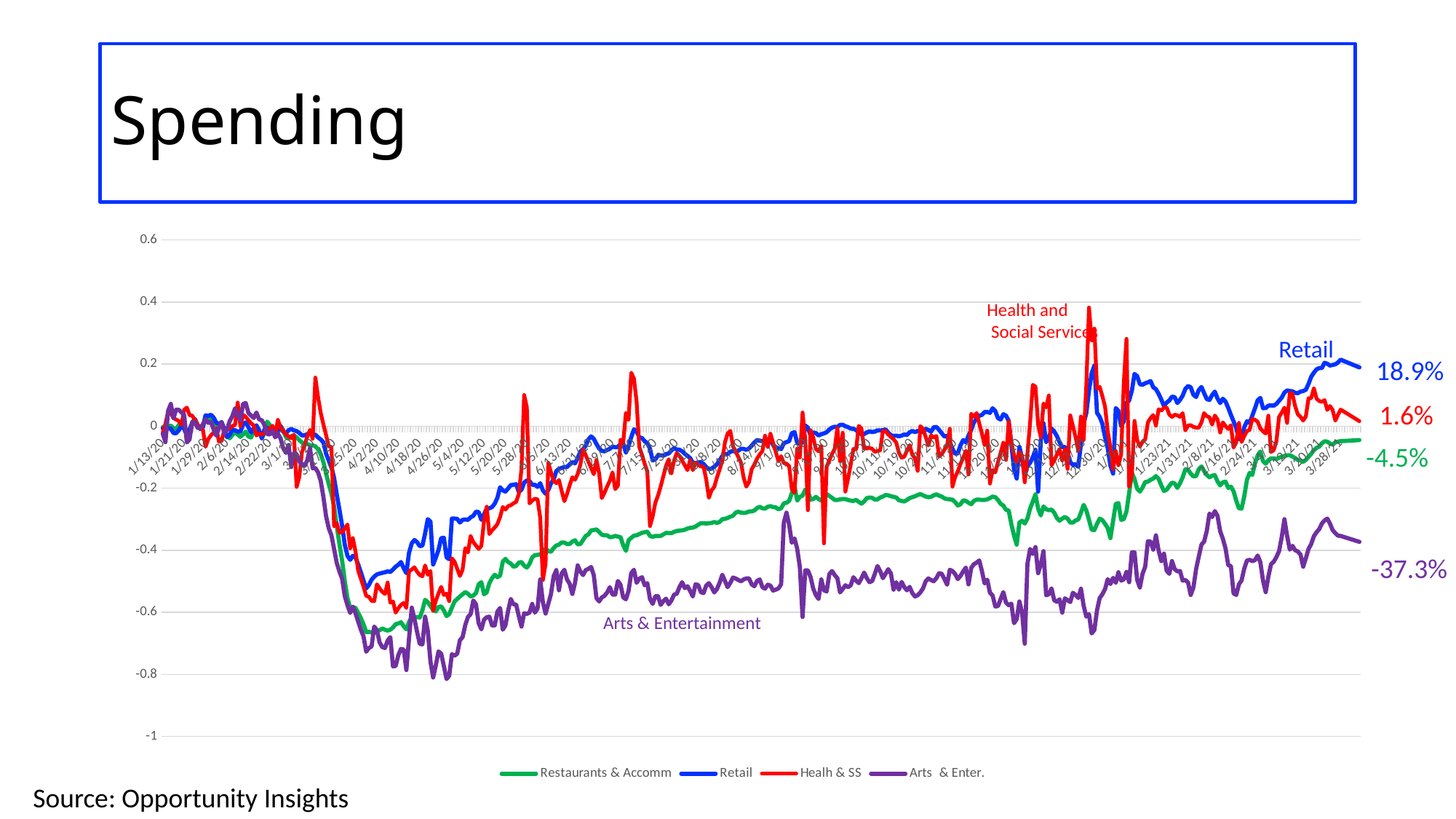
What type of chart is shown on the slide? line chart What is the difference between the labelled end values of Retail (18.9%) and Healh & SS (1.6%)? 17.3 percentage points What is the final labelled value for the Restaurants & Accomm series? -4.5% Which has the larger labelled end value, Healh & SS or Restaurants & Accomm? Healh & SS What is the final labelled value for the Healh & SS series? 1.6% What is the final labelled value for the Retail series? 18.9% Which series has the highest labelled end value? Retail What is the title of the slide containing the chart? Spending How many series does the legend list? 4 Is the lowest point of the Arts & Enter. series greater or less than -0.6? less What is the final labelled value for the Arts & Enter. series? -37.3% Which series has the lowest labelled end value? Arts & Enter.